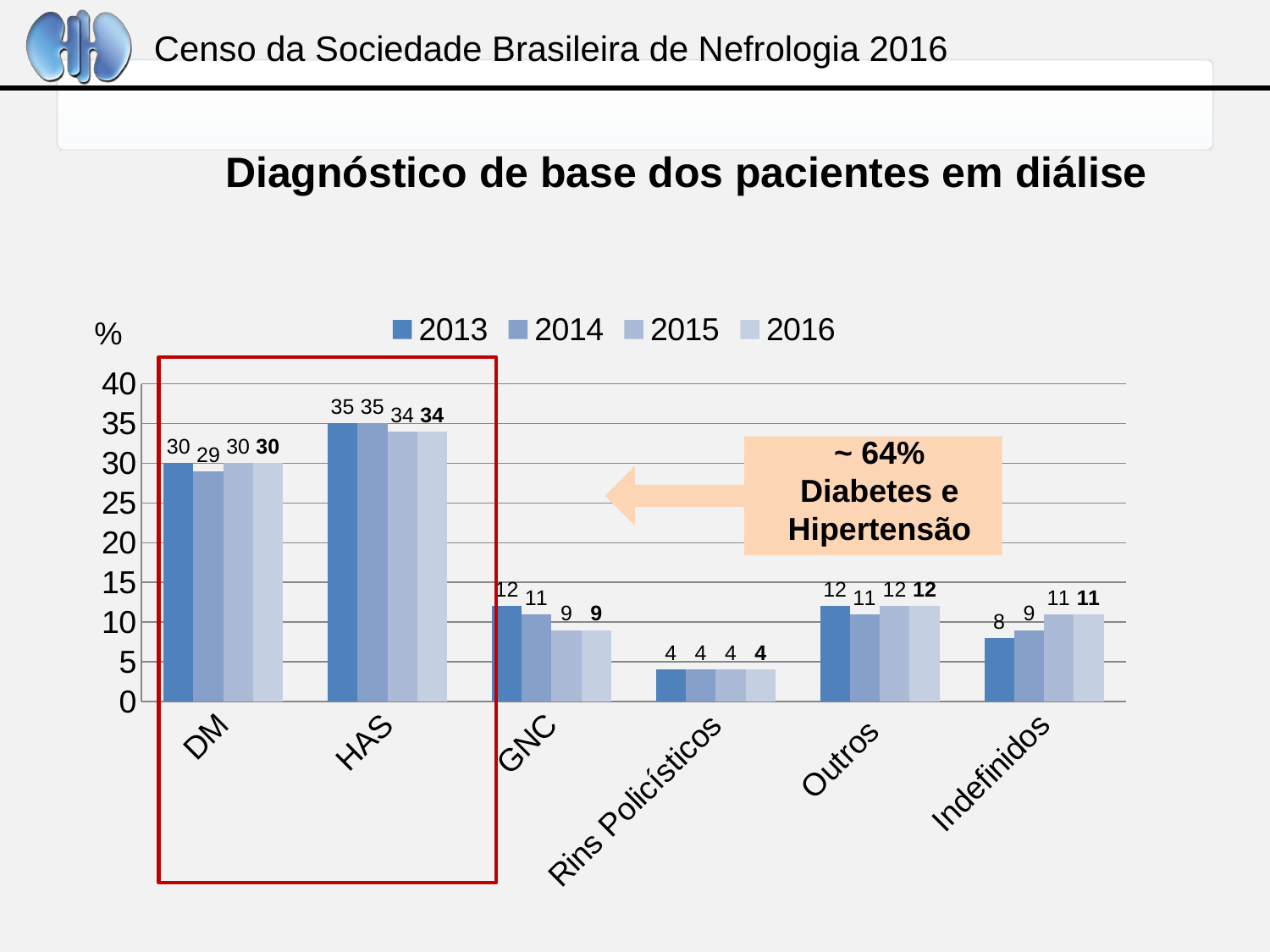
How many categories are shown on the x axis? 6 What is the value for DM in 2014? 29 What kind of chart is shown on the slide? Bar chart Which category has the lowest value in 2013? Rins Policísticos How many series does the legend list? 4 What is the difference between the 2013 and 2016 values for GNC? 3 What is the value for GNC in 2015? 9 Do the values for Indefinidos rise or fall from 2013 to 2016? Rise What is the value for Indefinidos in 2013? 8 What is the value for HAS in 2016? 34 Which is larger, the 2016 value for Outros or the 2016 value for Indefinidos? Outros Which category has the highest value in 2016? HAS